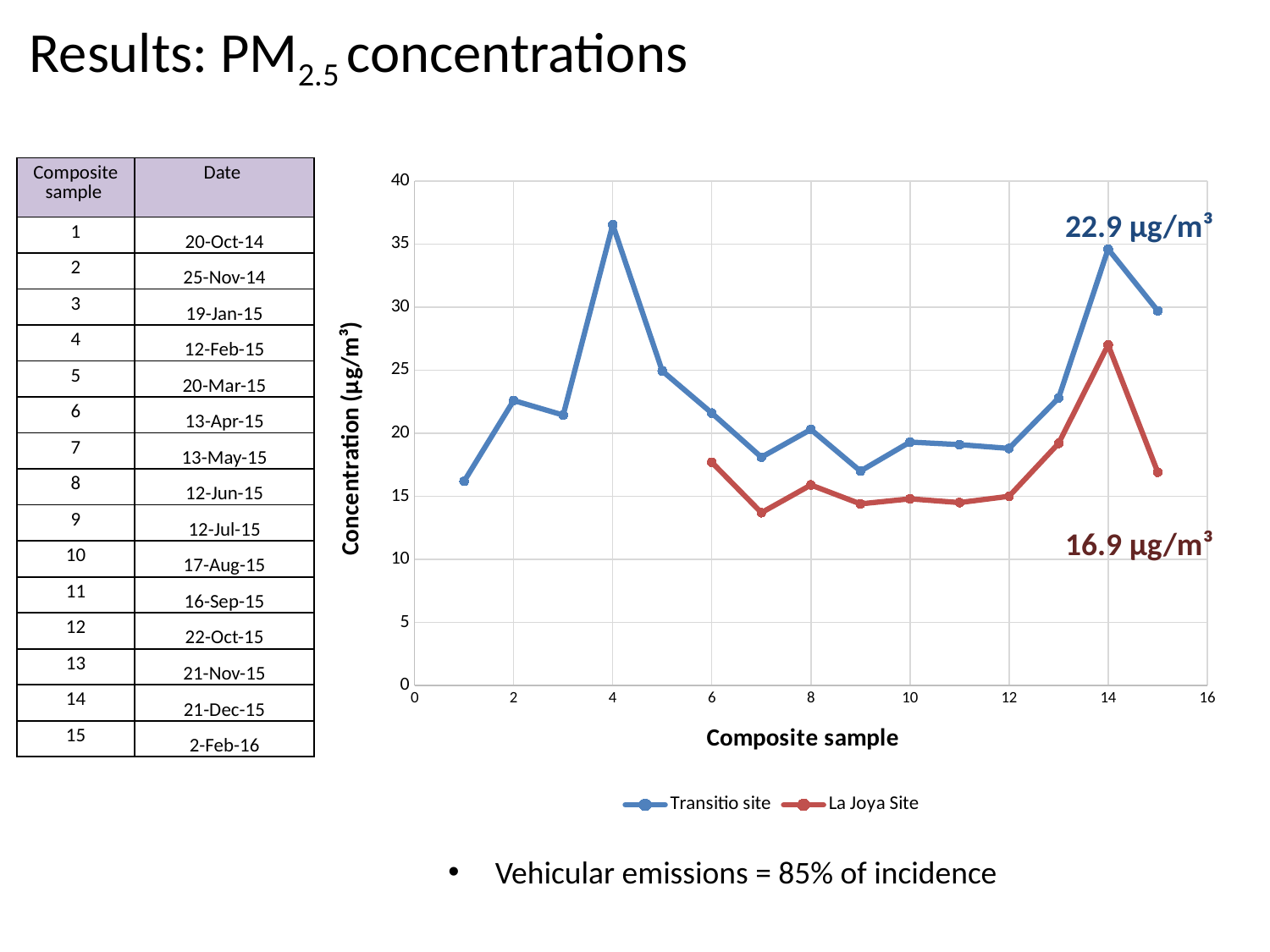
What are the two series named in the chart's legend? Transitio site and La Joya Site At which composite sample does the La Joya Site series reach its highest concentration? 14 At which composite sample does the Transitio site series reach its highest concentration? 4 Is the La Joya Site concentration at composite sample 7 greater or less than 15? less How many series does the chart's legend list? 2 Does the La Joya Site concentration rise or fall from composite sample 14 to composite sample 15? Fall Is the La Joya Site concentration at composite sample 14 greater or less than 25? greater What kind of chart is shown on the slide? Line chart How many data points are plotted for the La Joya Site series? 10 Is the Transitio site concentration at composite sample 4 greater or less than 35? greater At composite sample 8, which series has the higher concentration, Transitio site or La Joya Site? Transitio site